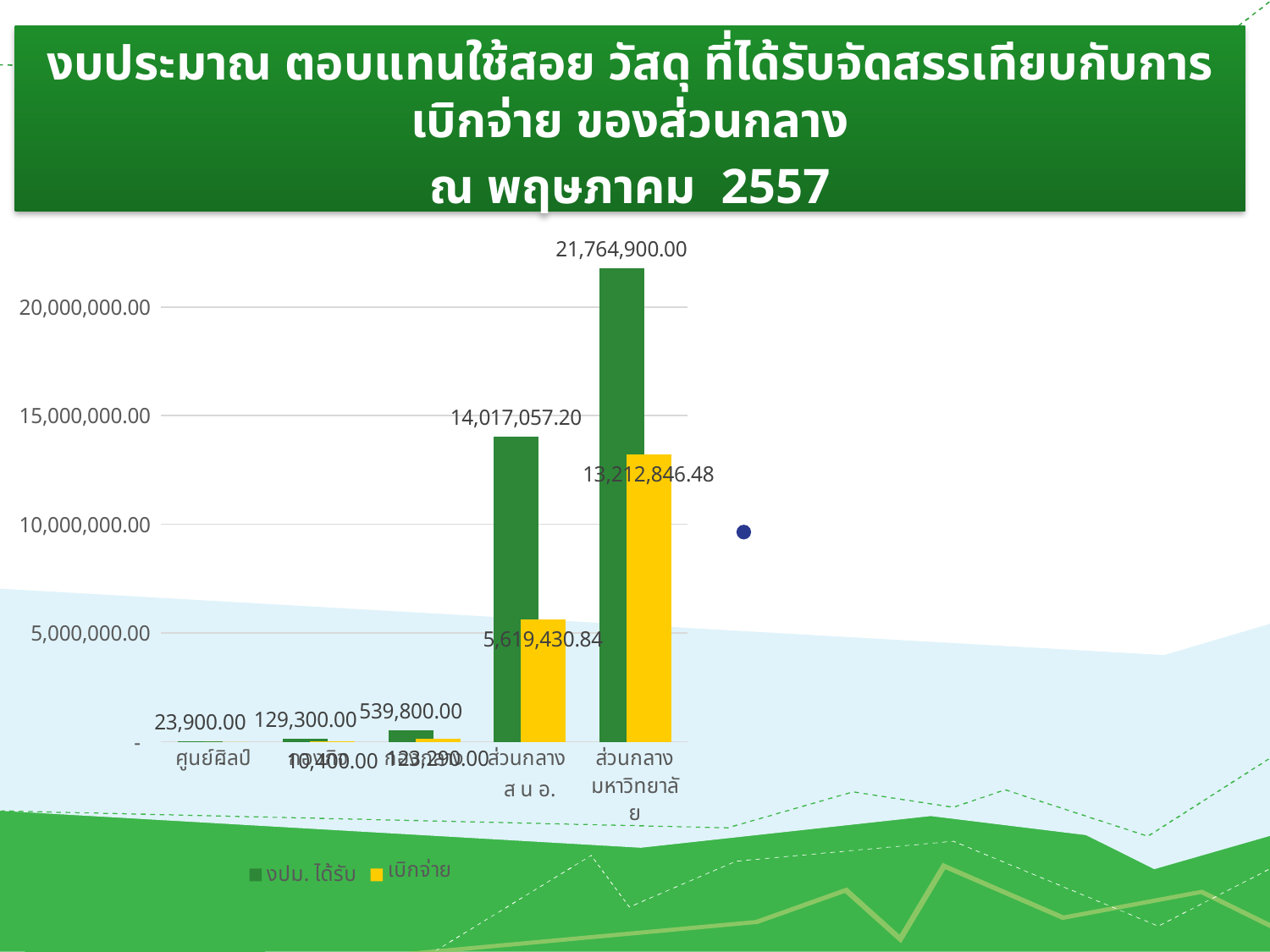
What is the difference between งปม. ได้รับ and เบิกจ่าย for ส่วนกลางมหาวิทยาลัย? 8,552,053.52 Is the เบิกจ่าย value for ส่วนกลางมหาวิทยาลัย greater or less than 10,000,000.00? greater Which category has the highest งปม. ได้รับ value? ส่วนกลางมหาวิทยาลัย What is the งปม. ได้รับ value for ส่วนกลาง สนอ.? 14,017,057.20 What is the งปม. ได้รับ value for ศูนย์ศิลป์? 23,900.00 What kind of chart is shown on the slide? bar chart What is the เบิกจ่าย value for ส่วนกลางมหาวิทยาลัย? 13,212,846.48 Which has the larger เบิกจ่าย value, ส่วนกลาง สนอ. or ส่วนกลางมหาวิทยาลัย? ส่วนกลางมหาวิทยาลัย How many series does the legend list? 2 What is the difference between งปม. ได้รับ and เบิกจ่าย for ส่วนกลาง สนอ.? 8,397,626.36 What is the งปม. ได้รับ value for ส่วนกลางมหาวิทยาลัย? 21,764,900.00 What is the เบิกจ่าย value for ส่วนกลาง สนอ.? 5,619,430.84